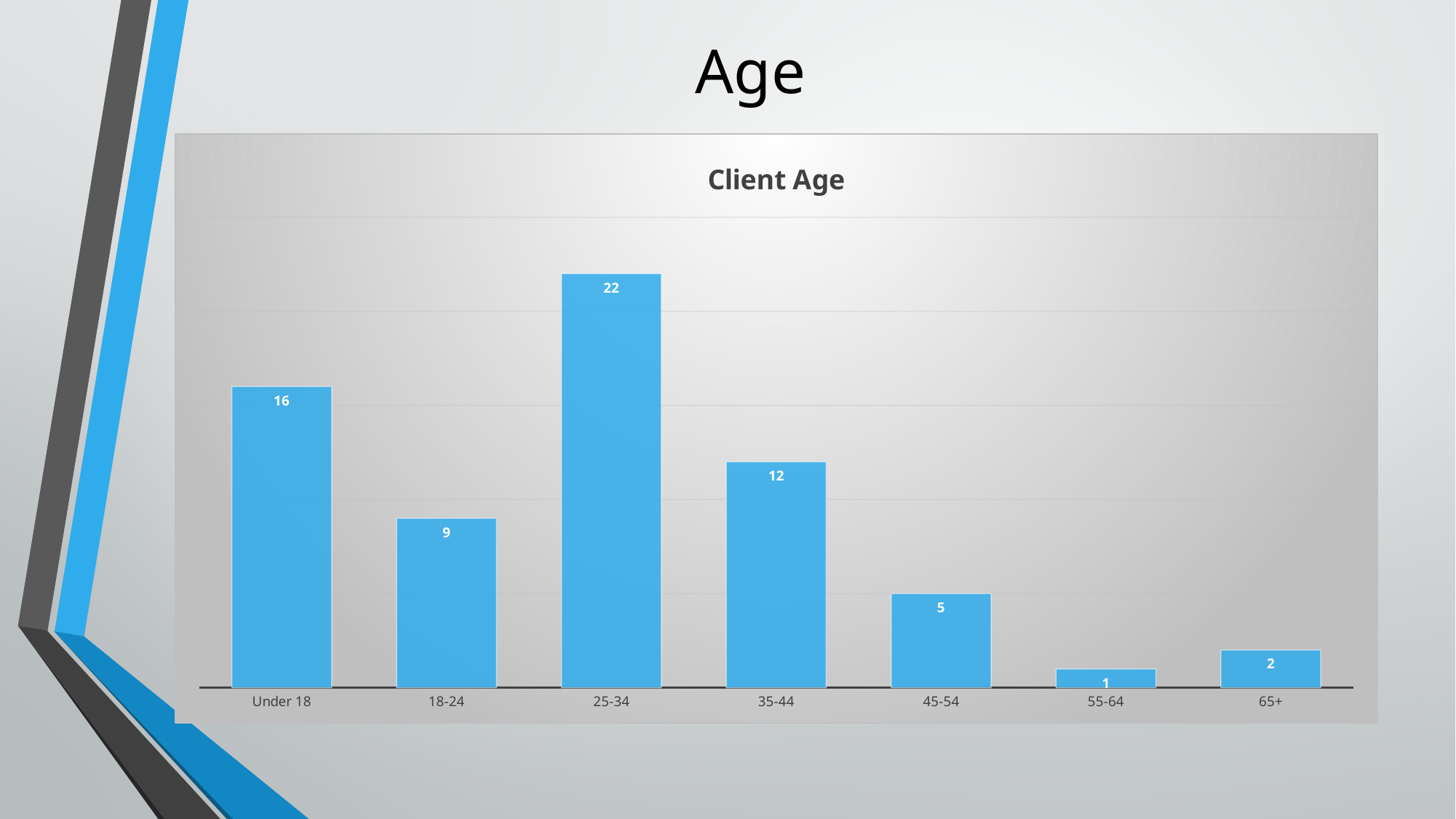
How many age categories are shown in the chart? 7 What is the value for the 25-34 age group in the Client Age chart? 22 Which age group has the highest value? 25-34 Which is larger, the value for 18-24 or the value for 35-44? 35-44 What is the value for the Under 18 category? 16 What is the title of the chart? Client Age What kind of chart is shown on the slide? Bar chart What is the value for the 45-54 age group? 5 What is the difference between the values for 25-34 and 35-44? 10 Which age group has the lowest value? 55-64 What is the value for the 65+ age group? 2 What is the difference between the values for Under 18 and 18-24? 7